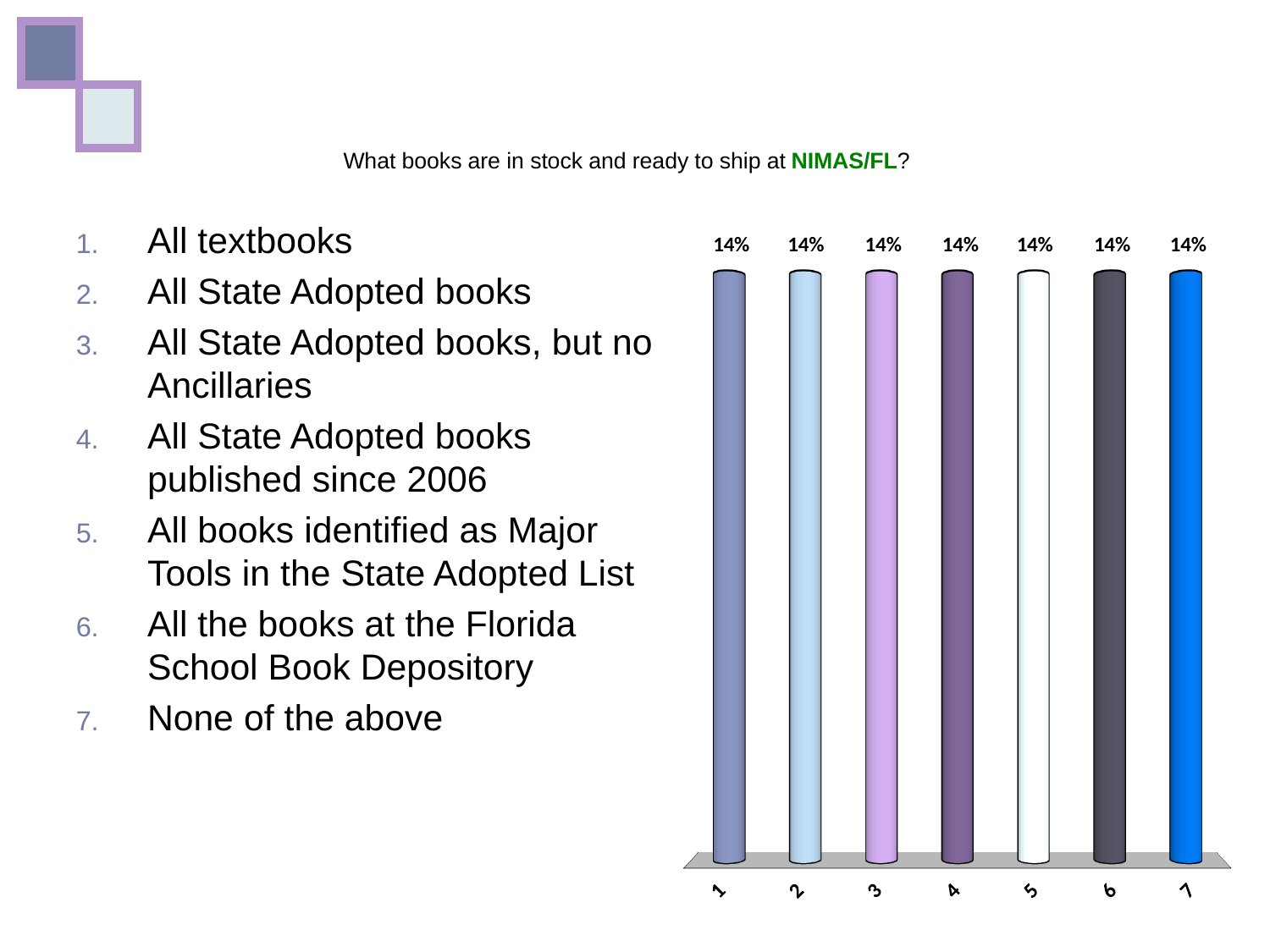
What is the total of the values for categories 1 and 2 combined? 28% What is the value shown for category 1? 14% What colour is the bar for category 7? blue What is the value shown for category 3? 14% What is the difference between the values for category 2 and category 6? 0% What is the value shown for category 4? 14% What is the value shown for category 7? 14% What kind of chart is shown on the slide? bar chart Do the values rise, fall, or stay the same from category 1 to category 7? stay the same What is the value shown for category 5? 14% What colour is the bar for category 5? white How many bars are plotted in the chart? 7